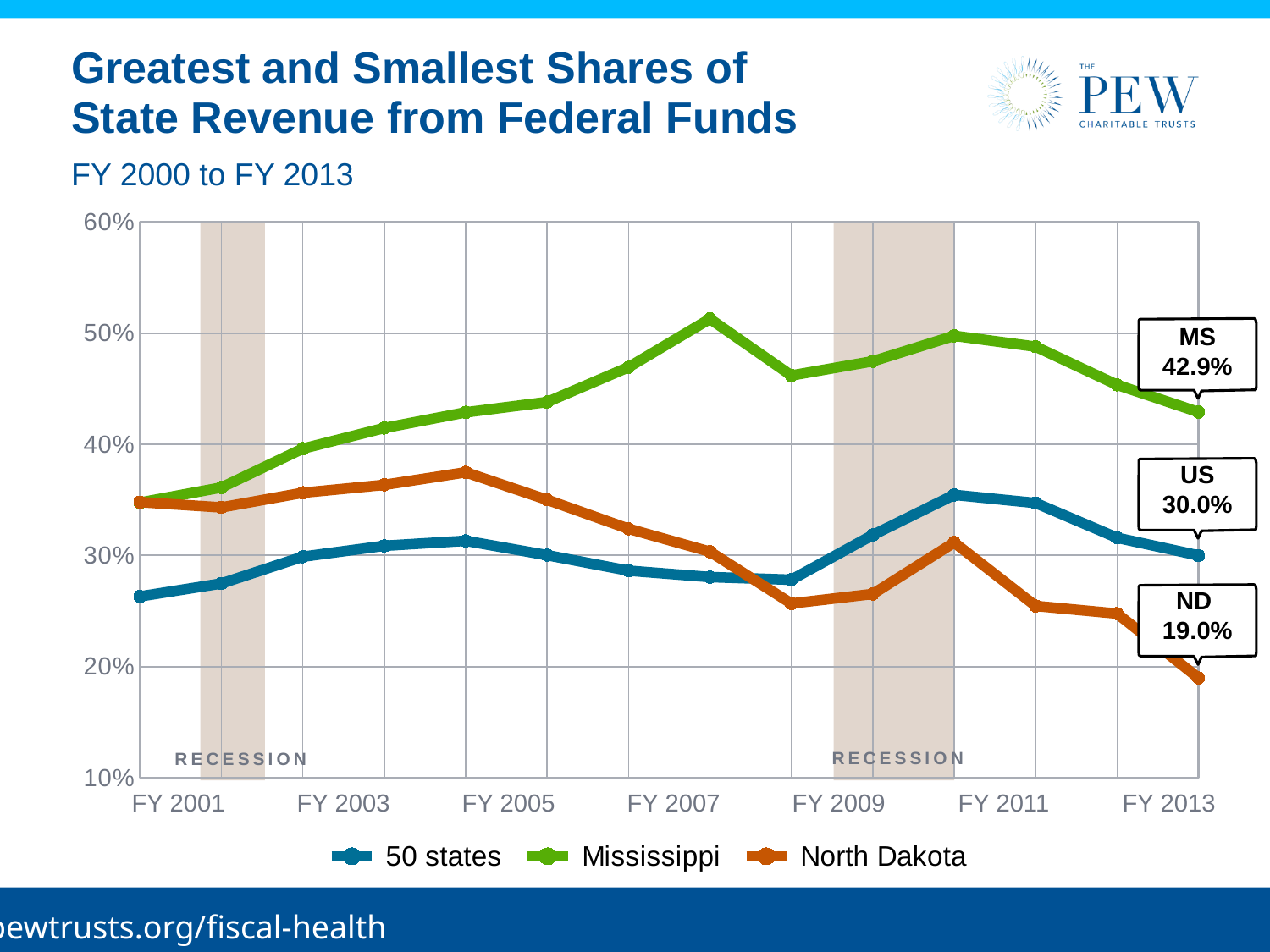
Which series has the highest value in FY 2013? Mississippi In FY 2013, which is larger: the value for Mississippi or the value for North Dakota? Mississippi What is the value for the 50 states (US) in FY 2013? 30.0% In FY 2013, how much higher is Mississippi's share than the 50 states' share? 12.9 percentage points Is the value for Mississippi in FY 2007 greater or less than 50%? greater How many series does the legend list? 3 What kind of chart is shown on the slide? Line chart What is the value for North Dakota (ND) in FY 2013? 19.0% In FY 2013, what is the difference between the 50 states' share and North Dakota's share? 11.0 percentage points What is the value for Mississippi (MS) in FY 2013? 42.9% Is the value for North Dakota in FY 2009 greater or less than 30%? less Which series has the lowest value in FY 2013? North Dakota